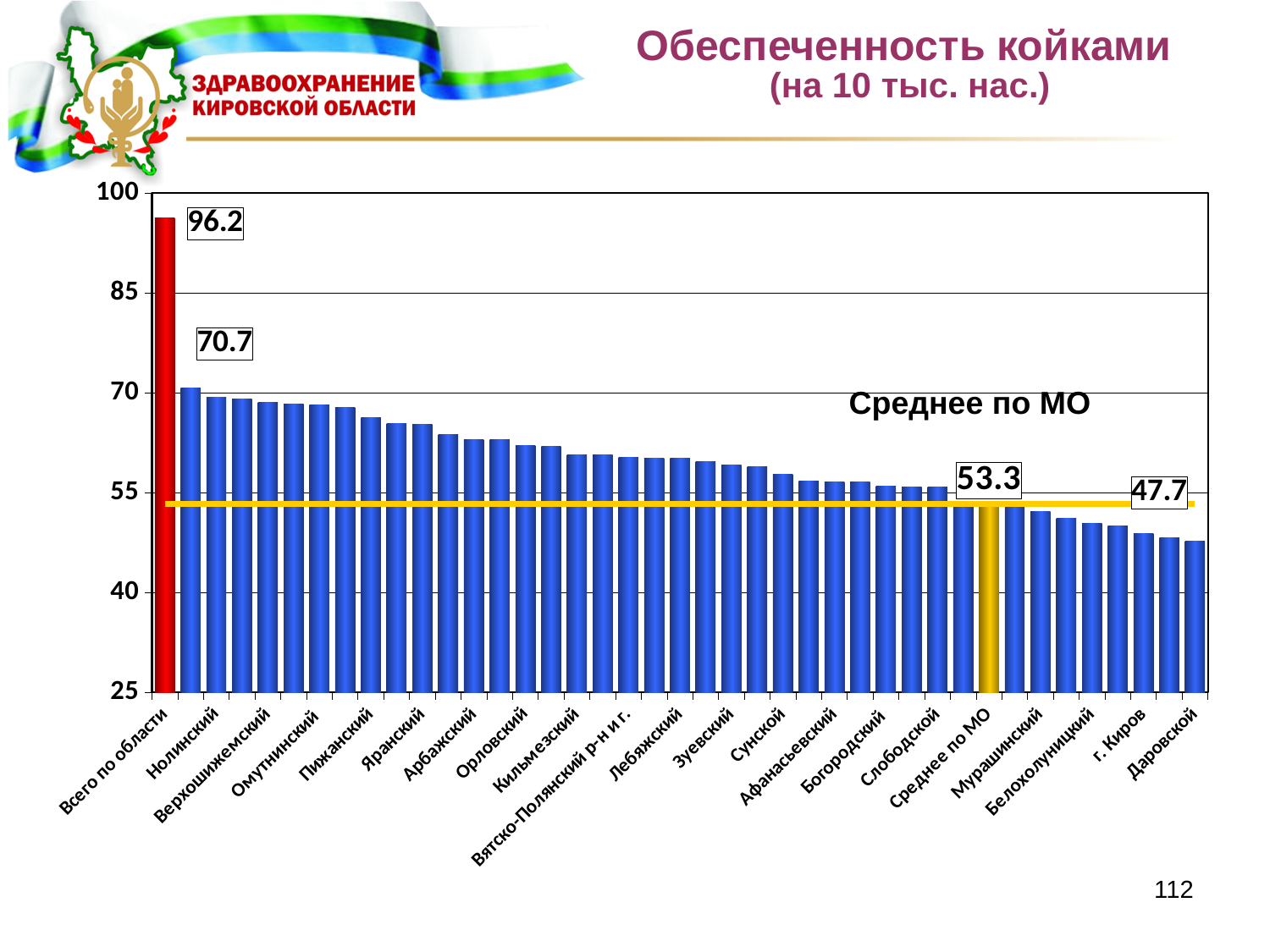
What is the value for Среднее по МО? 53.3 Which category has the lowest value? Даровской What kind of chart is shown on the slide? bar chart What is the value for Даровской? 47.7 Which is larger, the value for Нолинский or the value for Даровской? Нолинский What is the difference between the values for Среднее по МО and Даровской? 5.6 Is the value for Пижанский greater or less than 55? greater Is the value for г. Киров greater or less than 55? less What is the value for Всего по области? 96.2 Which category has the highest value? Всего по области